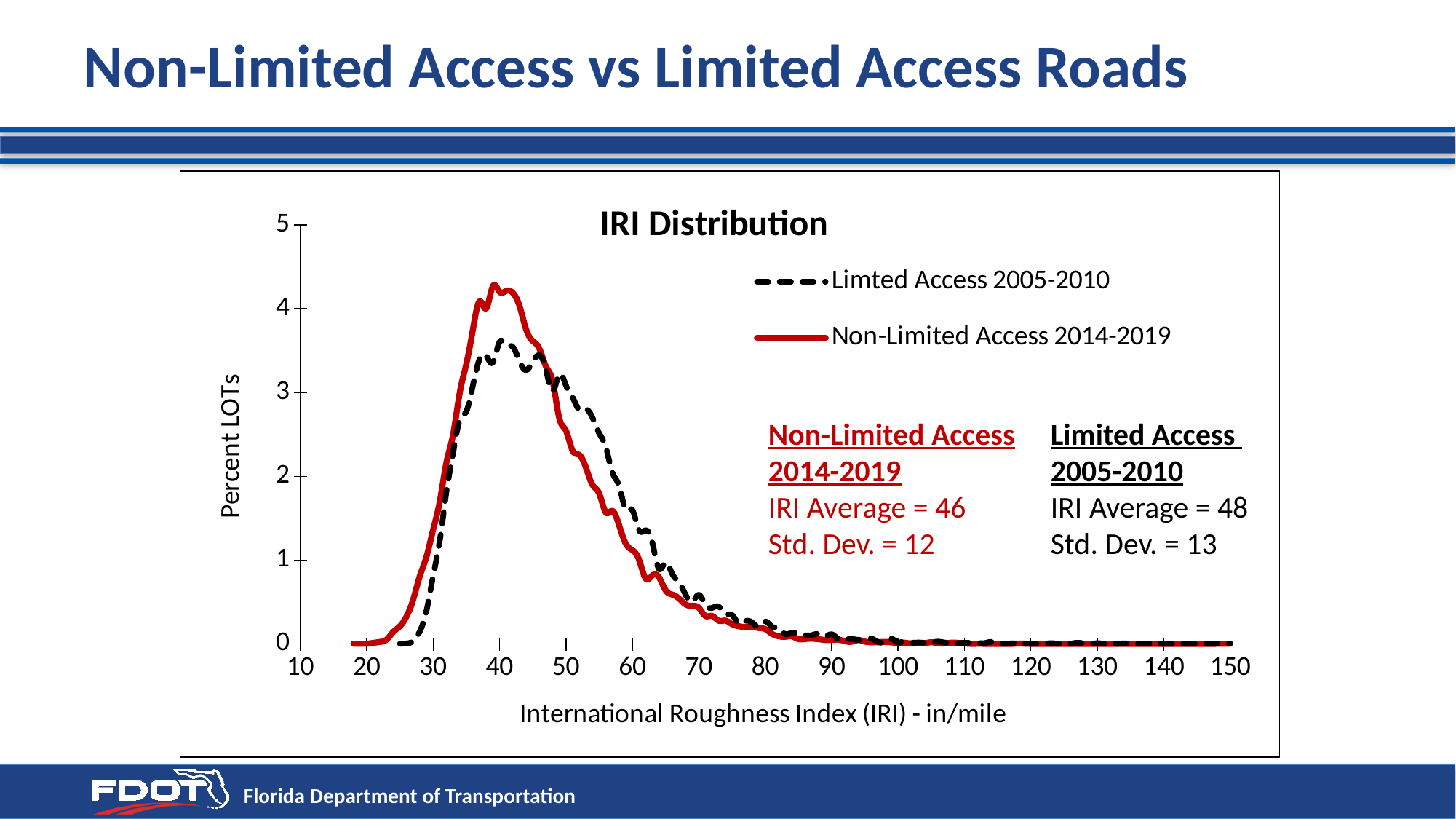
What kind of chart is the IRI Distribution chart? line chart What is the difference between the IRI Average for Limited Access 2005-2010 and for Non-Limited Access 2014-2019? 2 What is the label of the x axis of the IRI Distribution chart? International Roughness Index (IRI) - in/mile What is the IRI Average for Non-Limited Access 2014-2019 shown on the slide? 46 What is the Std. Dev. for Limited Access 2005-2010 shown on the slide? 13 How many series does the legend of the IRI Distribution chart list? 2 What is the IRI Average for Limited Access 2005-2010 shown on the slide? 48 Which series reaches the higher peak in the IRI Distribution chart? Non-Limited Access 2014-2019 At an IRI of 70 in/mile, is the Non-Limited Access 2014-2019 value greater or less than 1 Percent LOTs? less Is the peak value of the Limted Access 2005-2010 line greater or less than 4 Percent LOTs? less What is the title of the chart on the slide? IRI Distribution Is the peak value of the Non-Limited Access 2014-2019 line greater or less than 4 Percent LOTs? greater